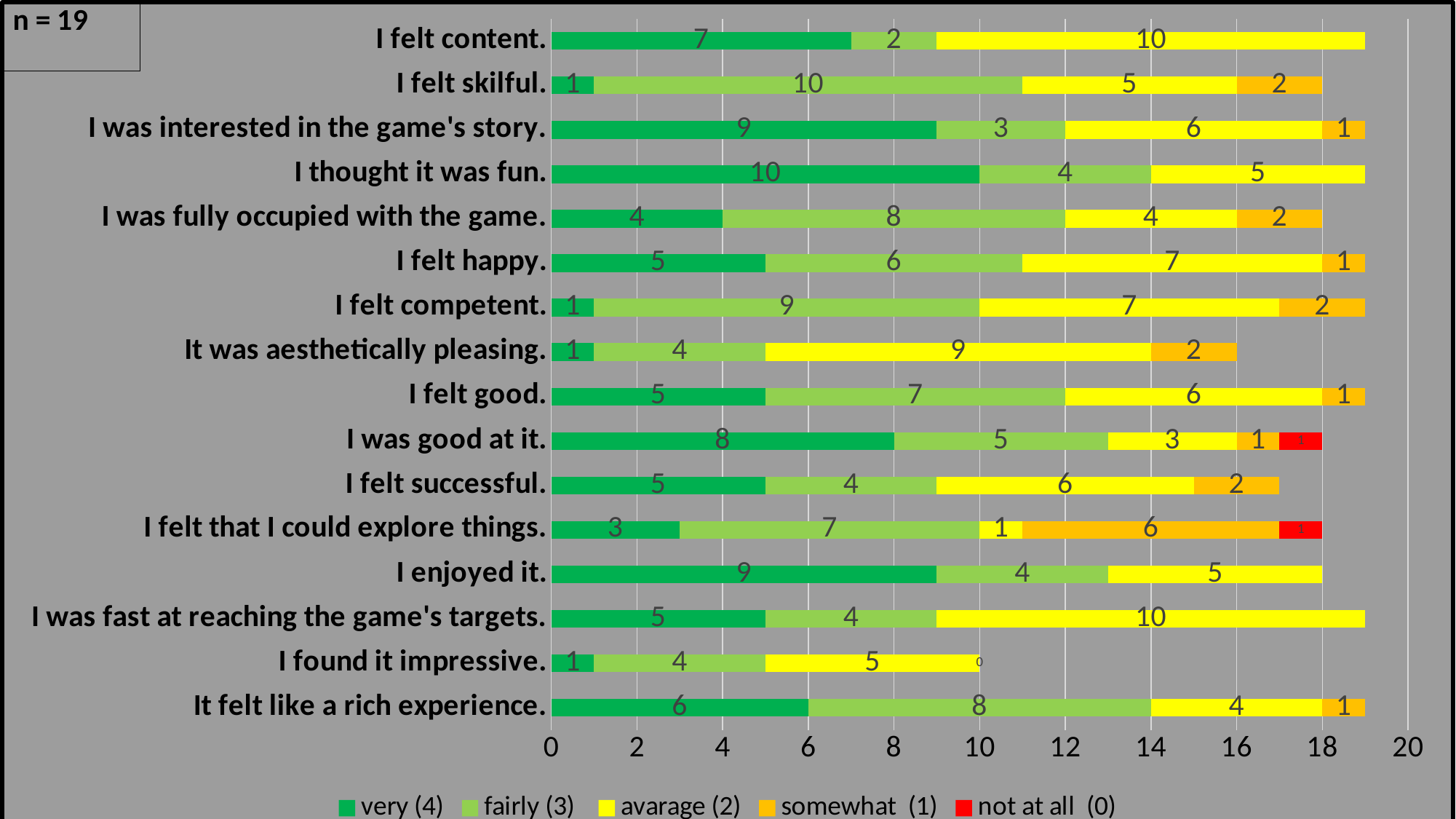
What type of chart is shown on the slide? stacked bar chart What sample size is shown in the box at the top left of the slide? n = 19 What is the difference between the 'fairly (3)' value for 'I felt skilful.' and the 'fairly (3)' value for 'I felt content.'? 8 Which statement has the shortest total bar? I found it impressive. Which is larger: the 'very (4)' value for 'I was good at it.' or the 'very (4)' value for 'I felt happy.'? I was good at it. What is the total of the stacked bar for 'I felt skilful.'? 18 What is the 'somewhat (1)' value for 'I felt that I could explore things.'? 6 Which statement has the highest 'very (4)' value? I thought it was fun. What is the 'avarage (2)' value for 'I was fast at reaching the game's targets.'? 10 How many statements (categories) are plotted on the chart? 16 How many series does the legend list? 5 What is the 'very (4)' value for 'I thought it was fun.'? 10